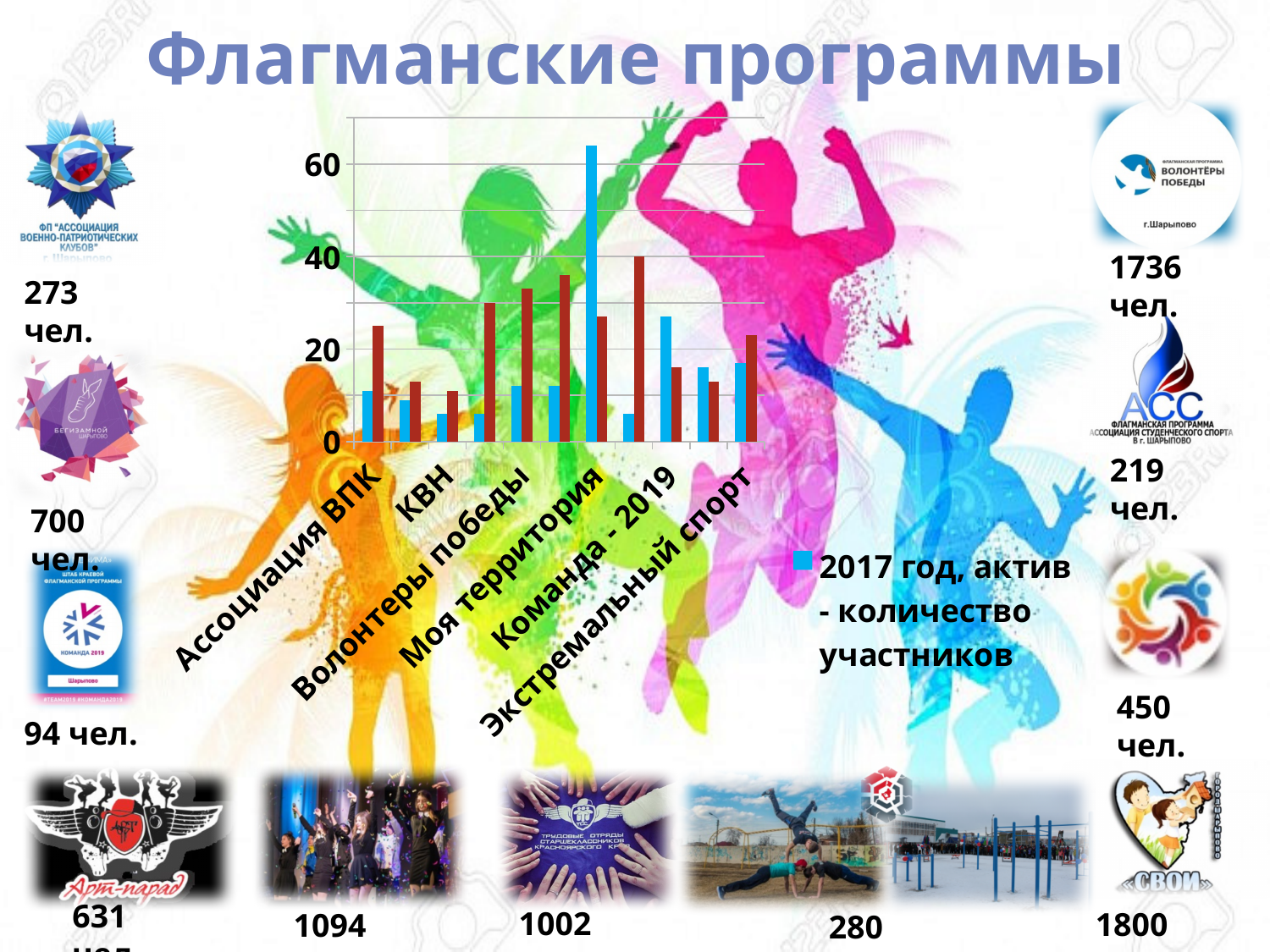
Is the 2017 год, актив value for Команда - 2019 greater or less than 20? greater What type of chart is shown on the slide? bar chart Is the 2017 год, актив value for Ассоциация ВПК greater or less than 20? less Which category has the tallest blue (2017 год, актив) bar in the chart? Моя территория What legend entry is shown for the blue bars in the chart? 2017 год, актив - количество участников Is the 2017 год, актив value for КВН greater or less than 20? less How many differently coloured bar series are plotted in the chart? 2 Which has the larger 2017 год, актив value: Моя территория or Ассоциация ВПК? Моя территория What is the highest value labelled on the vertical axis of the chart? 60